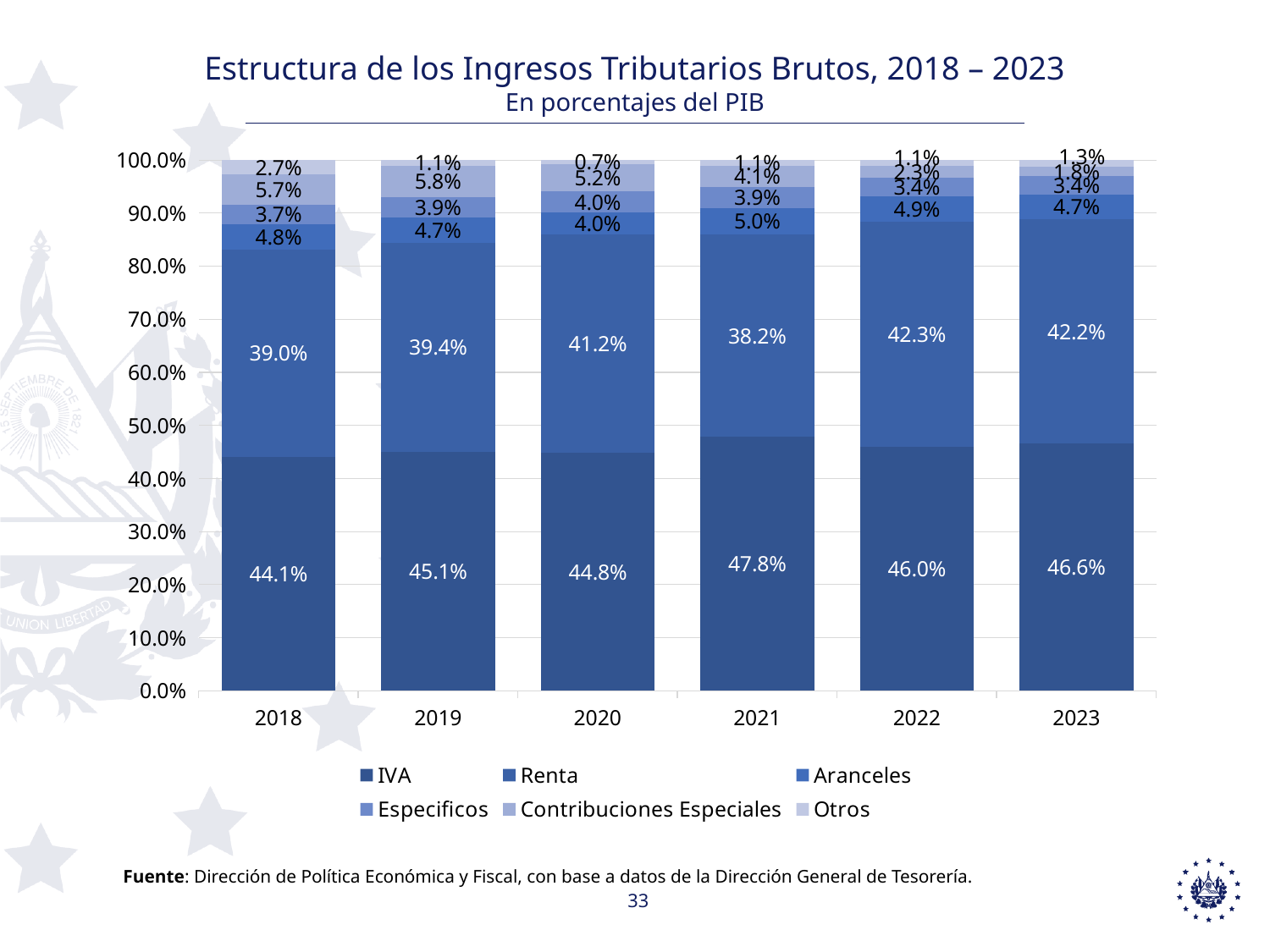
How many years are shown on the x axis? 6 What is the value for Otros in 2018? 2.7% Which is larger, the Renta value in 2020 or in 2019? 2020 What is the title of the chart? Estructura de los Ingresos Tributarios Brutos, 2018 – 2023 How many series does the legend list? 6 In which year is the Renta share lowest? 2021 In which year is the IVA share highest? 2021 What is the difference between the IVA value in 2023 and in 2018? 2.5% What kind of chart is shown on the slide? Stacked bar chart What is the value for Contribuciones Especiales in 2019? 5.8% What is the value for IVA in 2021? 47.8% What is the value for Renta in 2022? 42.3%